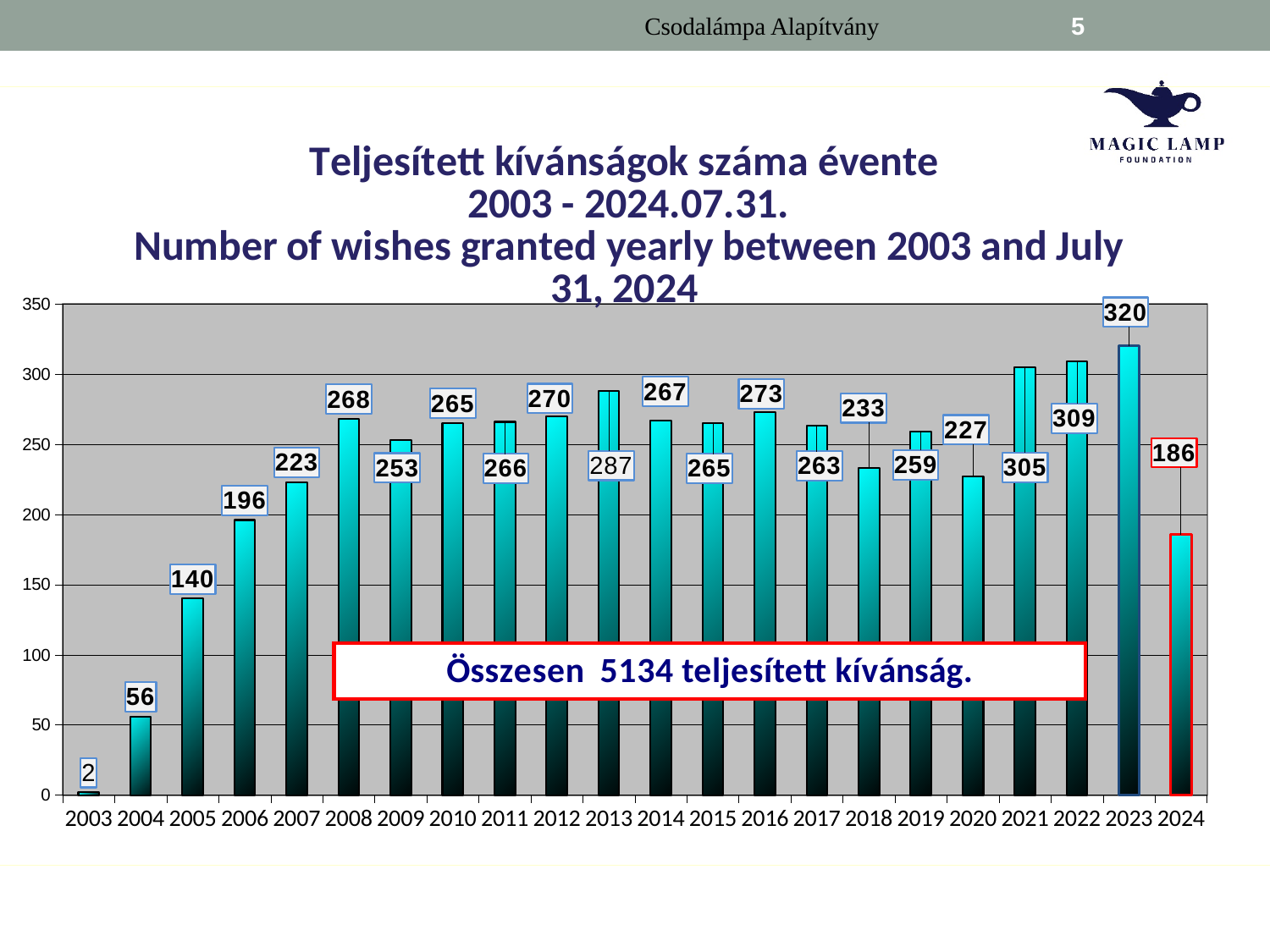
What total number of granted wishes is stated in the box on the chart? 5134 What kind of chart is shown on the slide? bar chart Which year has the lowest number of wishes granted? 2003 Which year has the highest number of wishes granted? 2023 How many years are shown on the x axis? 22 What is the difference between the values for 2023 and 2022? 11 How many wishes were granted in 2023? 320 Which is larger, the value for 2016 or the value for 2018? 2016 Is the value for 2021 greater or less than 300? greater What is the value shown for 2005? 140 What is the difference between the values for 2013 and 2020? 60 What is the value shown for 2024? 186